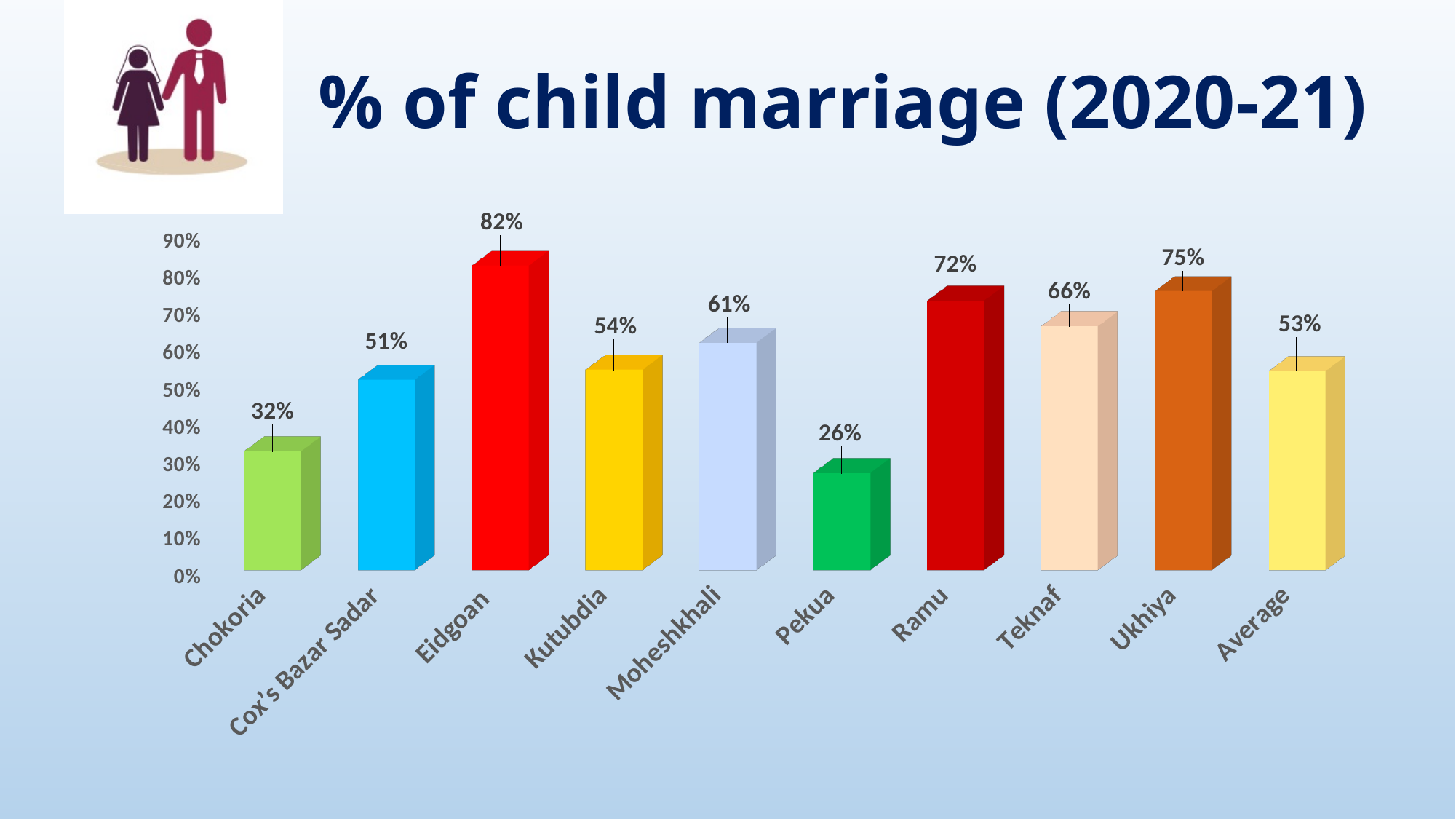
Is the value for Cox's Bazar Sadar greater or less than 60%? less What is the value for Teknaf? 66% What is the value for Eidgoan? 82% Which category has the lowest value? Pekua What is the value for Pekua? 26% What is the title of the slide? % of child marriage (2020-21) What is the Average value shown on the chart? 53% Which is larger, the value for Ramu or the value for Moheshkhali? Ramu What kind of chart is shown on the slide? bar chart Which category has the highest value? Eidgoan How many categories are shown on the x axis? 10 What is the difference between the values for Ukhiya and Chokoria? 43%